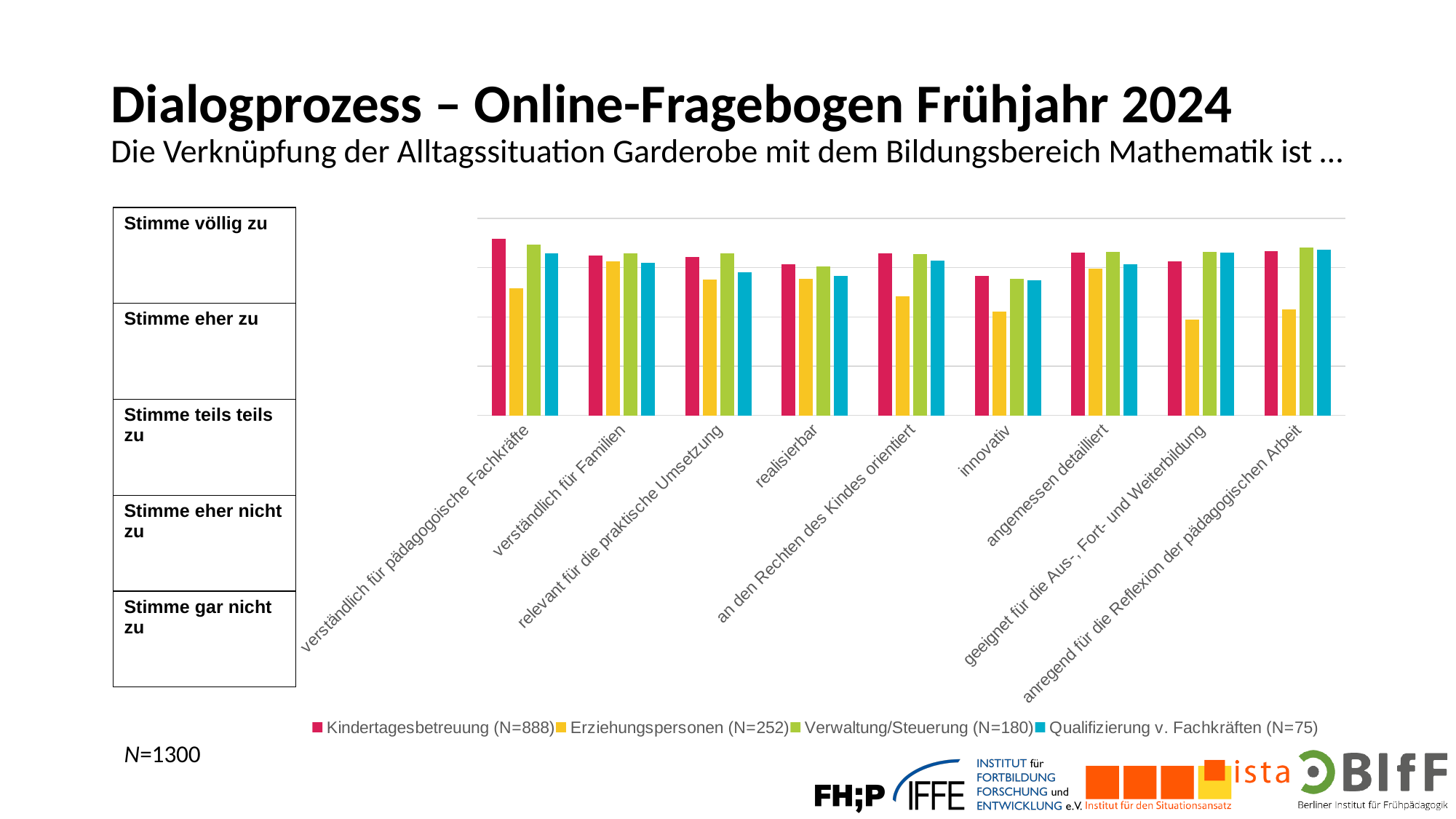
Which series in the legend has the largest sample size (N)? Kindertagesbetreuung (N=888) In the category 'anregend für die Reflexion der pädagogischen Arbeit', which is higher: the Erziehungspersonen bar or the Qualifizierung v. Fachkräften bar? Qualifizierung v. Fachkräften For which category is the Kindertagesbetreuung bar the lowest? innovativ What kind of chart is shown on the slide? bar chart In the category 'verständlich für pädagogische Fachkräfte', which series has the lowest bar? Erziehungspersonen (N=252) How many categories are shown along the x axis of the chart? 9 Which series has the lowest bar in the category 'geeignet für die Aus-, Fort- und Weiterbildung'? Erziehungspersonen (N=252) In the category 'an den Rechten des Kindes orientiert', which is higher: the Erziehungspersonen bar or the Verwaltung/Steuerung bar? Verwaltung/Steuerung What is the total N stated on the slide? N=1300 How many series does the chart's legend list? 4 In the category 'innovativ', which is higher: the Kindertagesbetreuung bar or the Erziehungspersonen bar? Kindertagesbetreuung For which category is the Kindertagesbetreuung bar the highest? verständlich für pädagogoische Fachkräfte